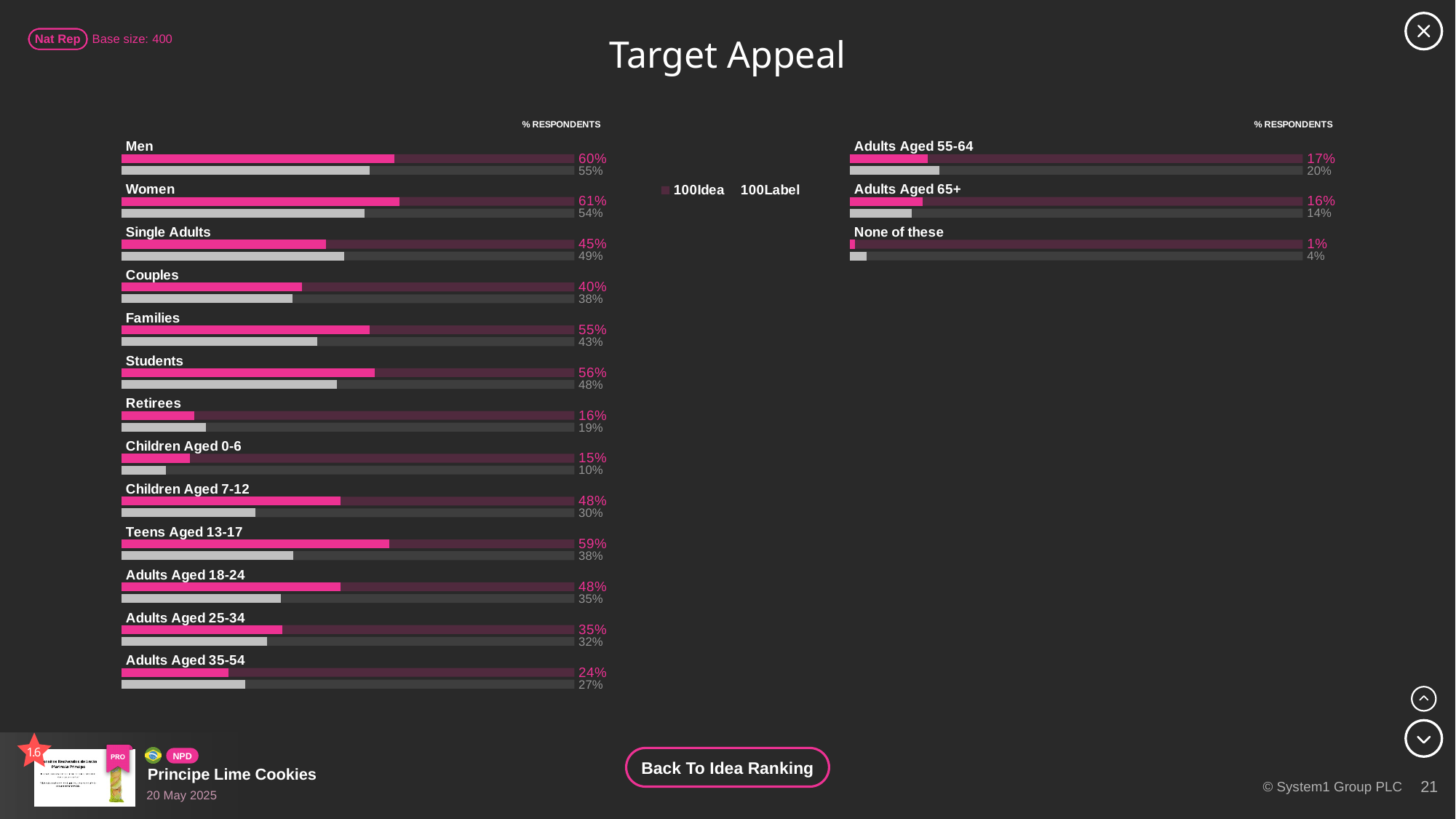
What kind of chart is shown on the slide? bar chart Which is larger for Single Adults, the pink bar or the grey bar? the grey bar How many categories are shown on the slide? 16 Which category has the lowest pink bar value? None of these What is the difference between the pink and grey bar values for Children Aged 7-12? 18% What is the difference between the pink bar values for Men and Women? 1% What is the value of the grey bar for Adults Aged 55-64? 20% What is the value of the pink bar for Teens Aged 13-17? 59% How many series does the legend list? 2 Which category has the highest pink bar value? Women What is the value of the grey bar for Families? 43% What is the value of the pink bar for Men? 60%